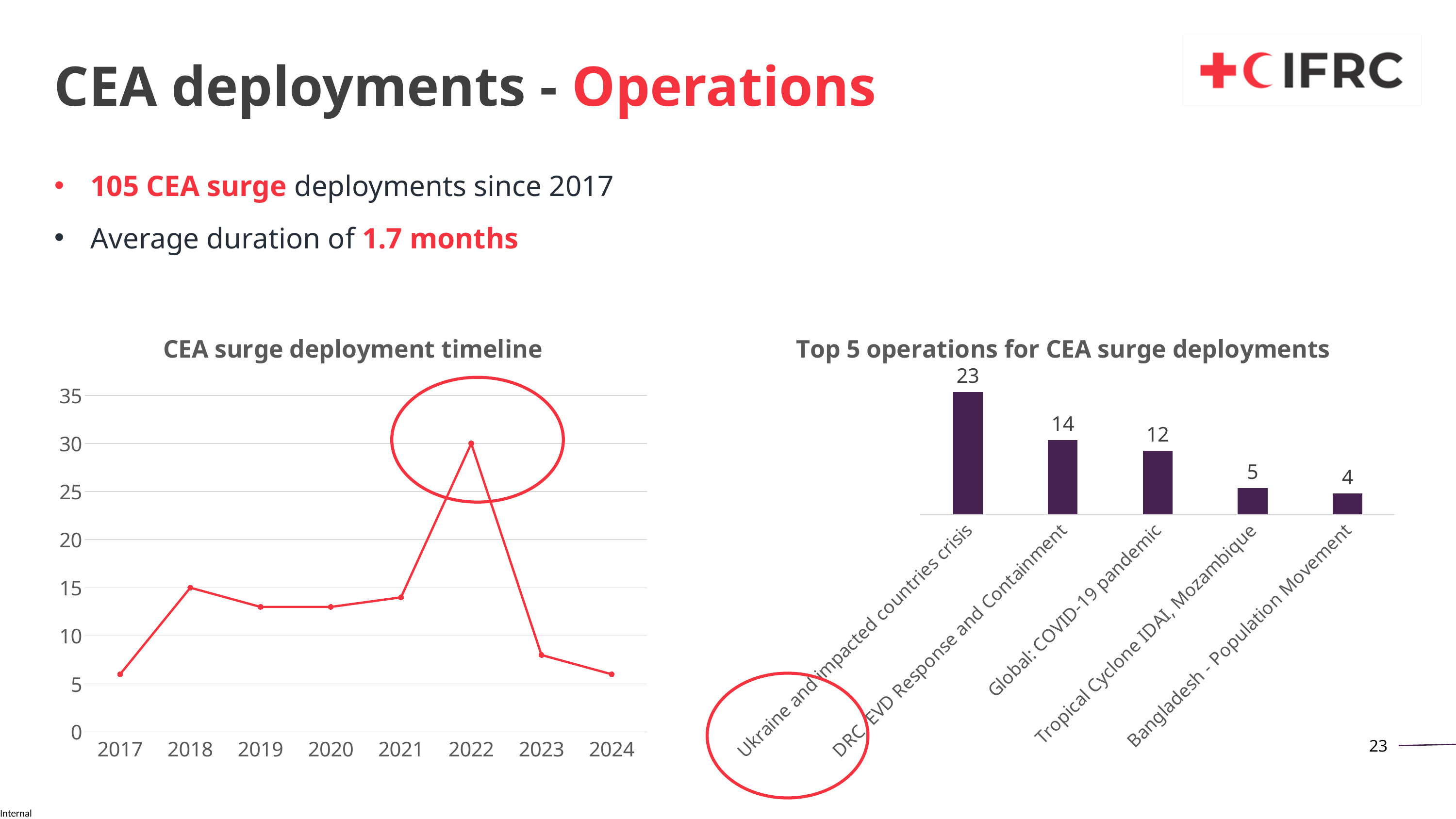
In the 'CEA surge deployment timeline' chart, which year has the highest value? 2022 In the 'Top 5 operations for CEA surge deployments' chart, which operation has the lowest value? Bangladesh - Population Movement In the 'CEA surge deployment timeline' chart, how many years are shown on the x axis? 8 What kind of chart is 'CEA surge deployment timeline'? Line chart In the 'Top 5 operations for CEA surge deployments' chart, what is the value for Global: COVID-19 pandemic? 12 In the 'CEA surge deployment timeline' chart, what is the value for 2022? 30 In the 'Top 5 operations for CEA surge deployments' chart, what is the value for Ukraine and impacted countries crisis? 23 In the 'CEA surge deployment timeline' chart, which is larger, the value for 2018 or the value for 2024? 2018 What kind of chart is 'Top 5 operations for CEA surge deployments'? Bar chart In the 'CEA surge deployment timeline' chart, is the value for 2023 greater or less than 10? less In the 'Top 5 operations for CEA surge deployments' chart, what is the difference between DRC EVD Response and Containment and Tropical Cyclone IDAI, Mozambique? 9 In the 'Top 5 operations for CEA surge deployments' chart, how many operations are shown? 5